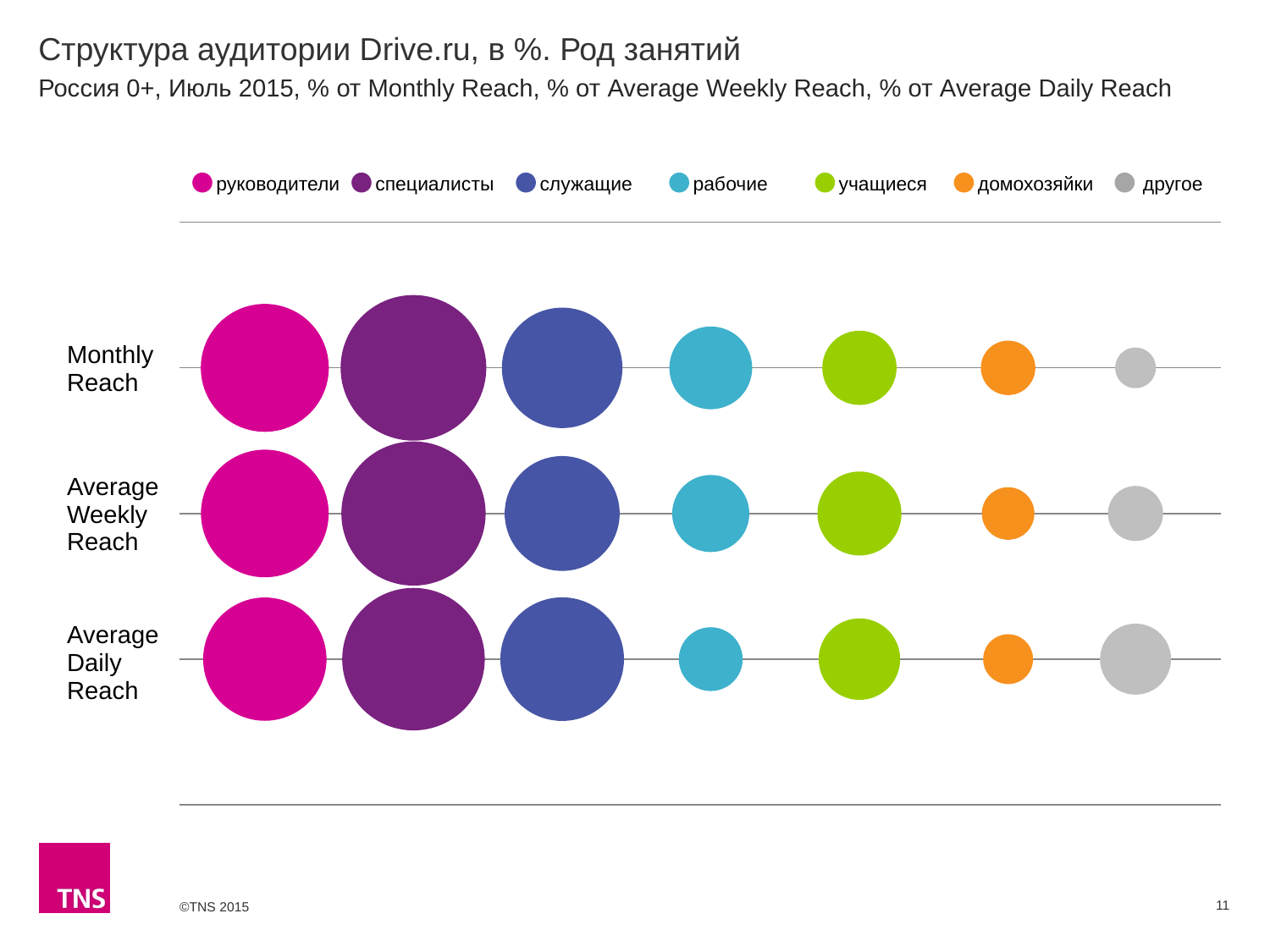
Which occupation group has the largest bubble in the Average Daily Reach row? специалисты In the Monthly Reach row, which bubble is larger: руководители or служащие? руководители What kind of chart is shown on the slide? bubble chart In the Average Daily Reach row, which bubble is larger: учащиеся or рабочие? учащиеся How many reach categories (rows) are plotted on the chart? 3 Which occupation group has the smallest bubble in the Average Daily Reach row? домохозяйки Which occupation group has the largest bubble in the Monthly Reach row? специалисты What colour is the bubble for домохозяйки? orange How many series does the legend list? 7 Which occupation group has the smallest bubble in the Monthly Reach row? другое Does the bubble for другое get larger or smaller going from Monthly Reach to Average Daily Reach? larger Which legend entry is shown in grey? другое